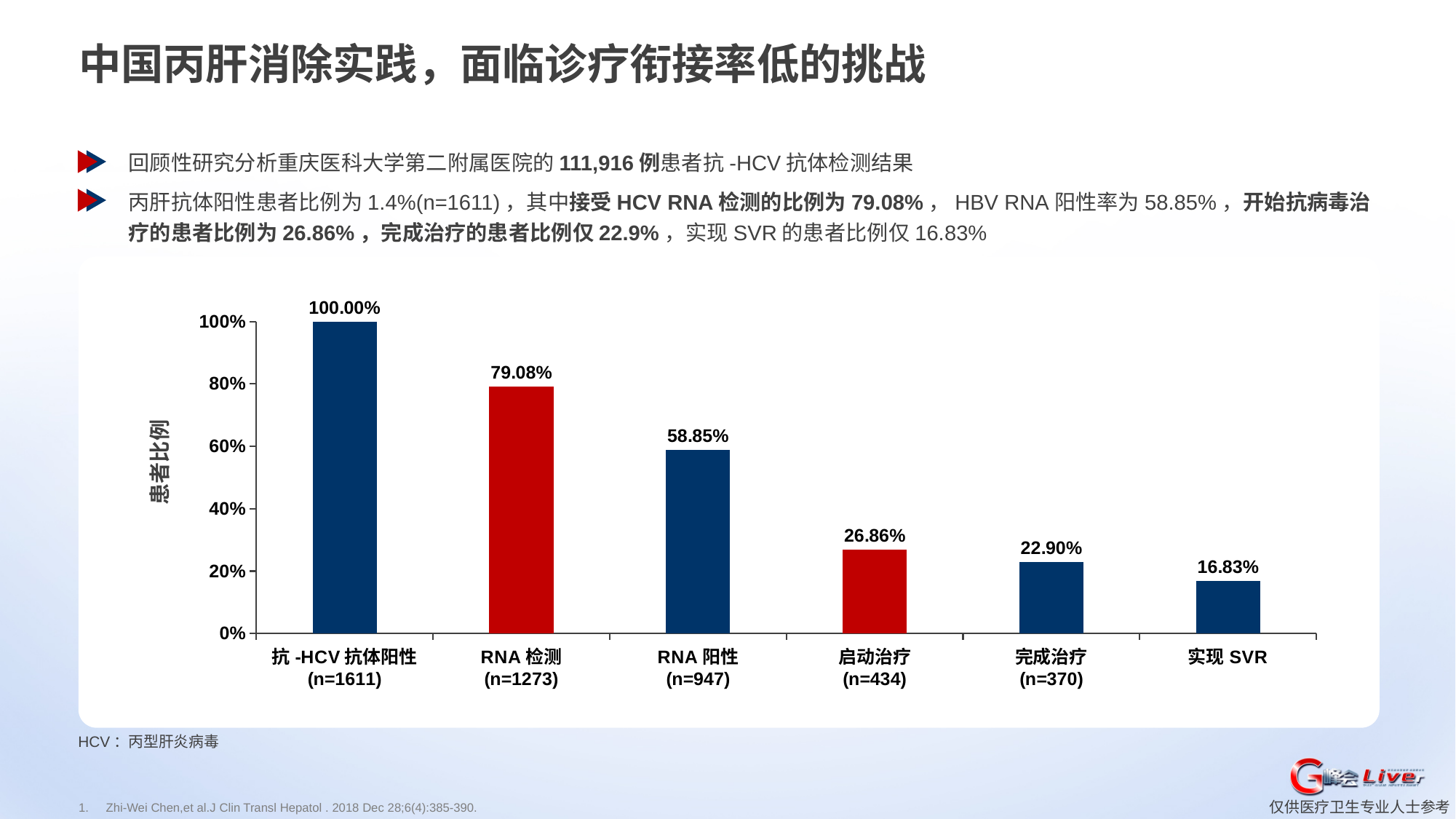
What kind of chart is shown? bar chart Which category has the highest value? 抗 -HCV 抗体阳性 (n=1611) Is the value for RNA 阳性 greater or less than 60%? less What is the value for RNA 检测 (n=1273)? 79.08% What is the label of the y axis? 患者比例 Do the values rise or fall from left to right along the x axis? fall What is the value for 实现 SVR? 16.83% Which is larger, the value for 完成治疗 or the value for 实现 SVR? 完成治疗 How many categories are shown on the x axis? 6 What is the difference between the values for RNA 检测 and RNA 阳性? 20.23% What is the value for 启动治疗 (n=434)? 26.86% Which category has the lowest value? 实现 SVR